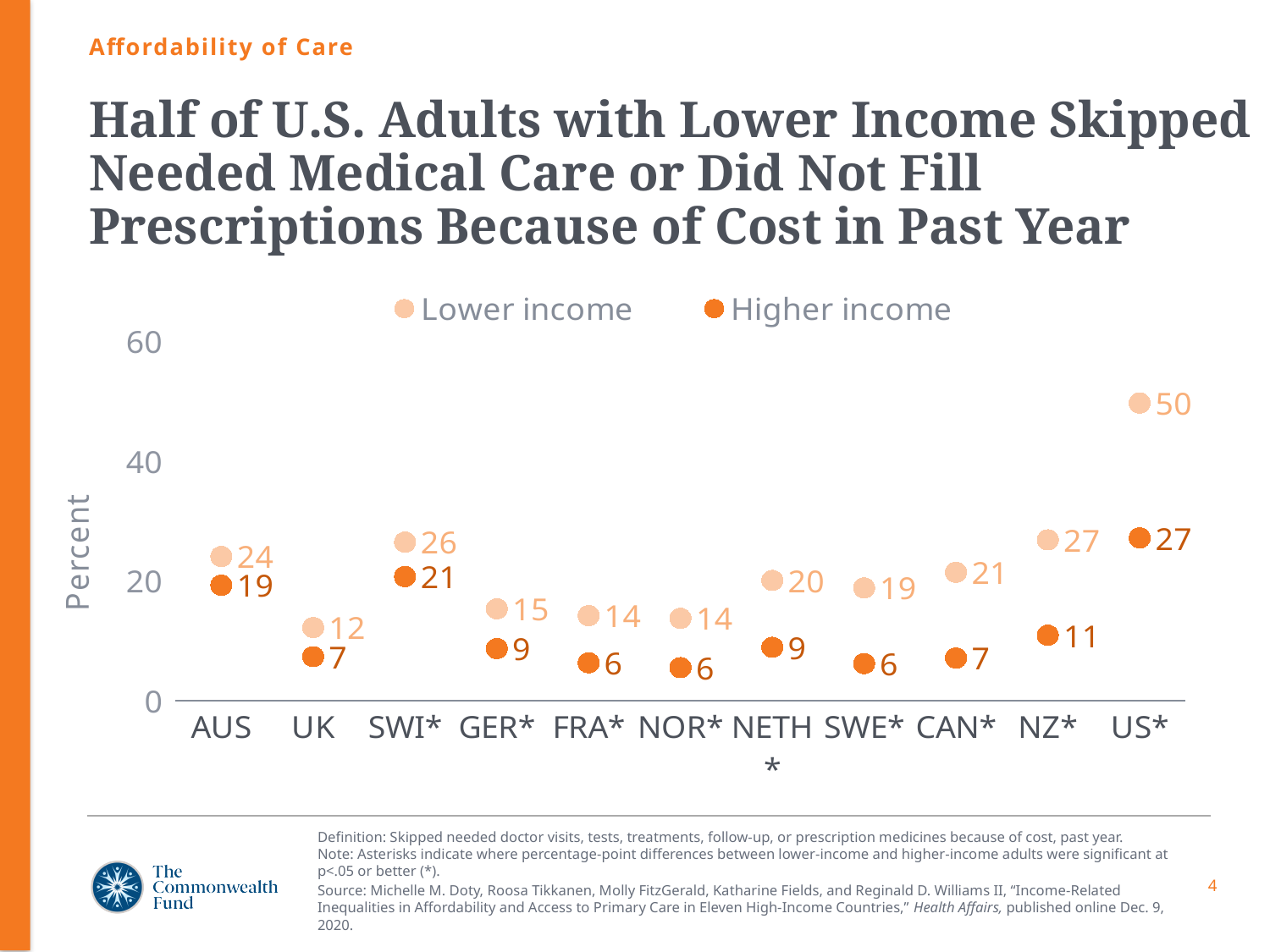
What is the difference between the Lower income and Higher income values for NZ*? 16 What is the Lower income value for US*? 50 Which country has the highest Lower income value? US* What is the Lower income value for SWI*? 26 What is the Higher income value for AUS? 19 What is the difference between the Lower income and Higher income values for US*? 23 How many countries are shown on the x axis? 11 Which is larger, the Higher income value for SWI* or the Higher income value for NZ*? SWI* What kind of chart is this? Dot plot What is the label on the y axis? Percent How many series does the legend list? 2 Which country has the lowest Lower income value? UK